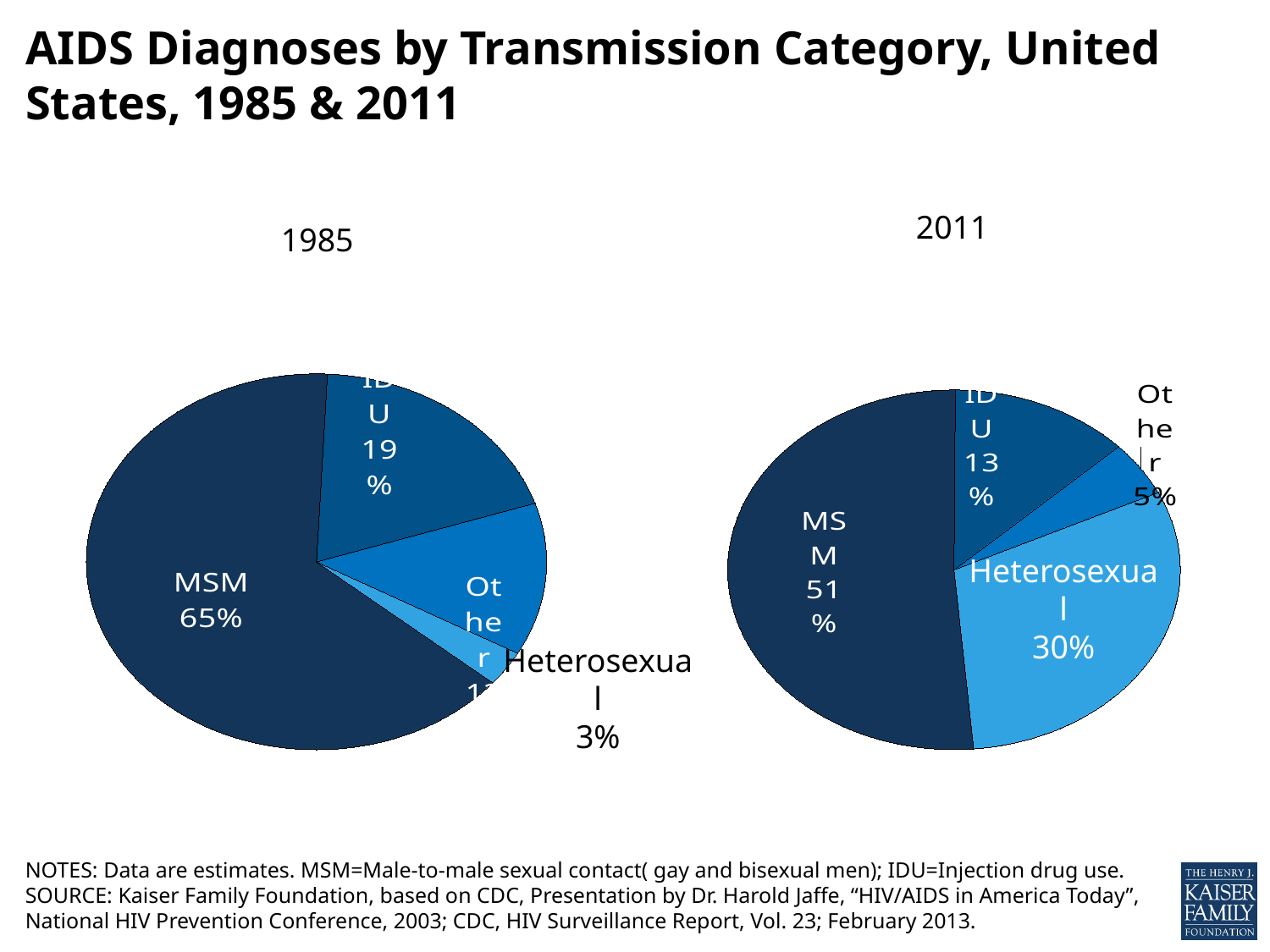
In the 1985 pie chart, what share of AIDS diagnoses is attributed to MSM? 65% By how many percentage points did the MSM share fall from the 1985 pie chart to the 2011 pie chart? 14 percentage points In the 2011 pie chart, what percentage is shown for IDU? 13% In the 2011 pie chart, what share of AIDS diagnoses is attributed to MSM? 51% In the 2011 pie chart, which is larger: the Heterosexual slice or the IDU slice? Heterosexual In the 2011 pie chart, what percentage is shown for Heterosexual? 30% In the 1985 pie chart, what percentage is shown for Heterosexual? 3% In the 2011 pie chart, which transmission category has the largest slice? MSM In the 2011 pie chart, what percentage is shown for Other? 5% In the 1985 pie chart, what percentage is shown for IDU? 19% In the 2011 pie chart, which transmission category has the smallest slice? Other What type of chart is used to show the 1985 and 2011 data on this slide? Pie chart